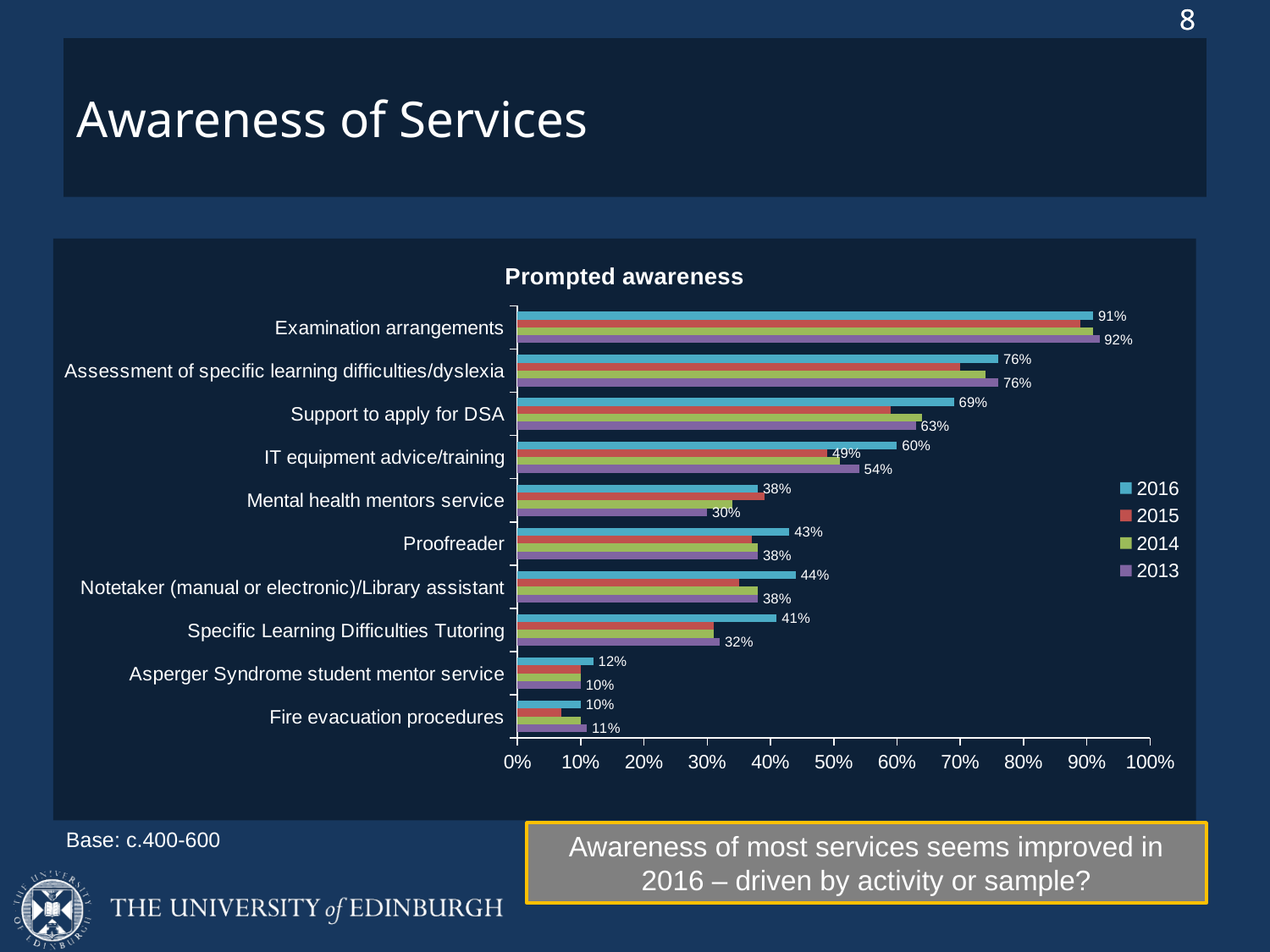
Which is larger in 2016: Support to apply for DSA or IT equipment advice/training? Support to apply for DSA Which service has the highest 2016 awareness value? Examination arrangements Which service has the lowest 2016 awareness value? Fire evacuation procedures Is the 2015 value for Examination arrangements greater or less than 80%? greater How many service categories are plotted on the chart? 10 What is the 2013 value for Mental health mentors service? 30% What is the 2013 prompted awareness value for Examination arrangements? 92% What kind of chart is shown on the slide? Bar chart What is the 2016 prompted awareness value for Examination arrangements? 91% What is the 2016 value for Support to apply for DSA? 69% By how many percentage points does the 2016 value for Support to apply for DSA exceed its 2013 value? 6 percentage points How many series does the legend of the chart list? 4